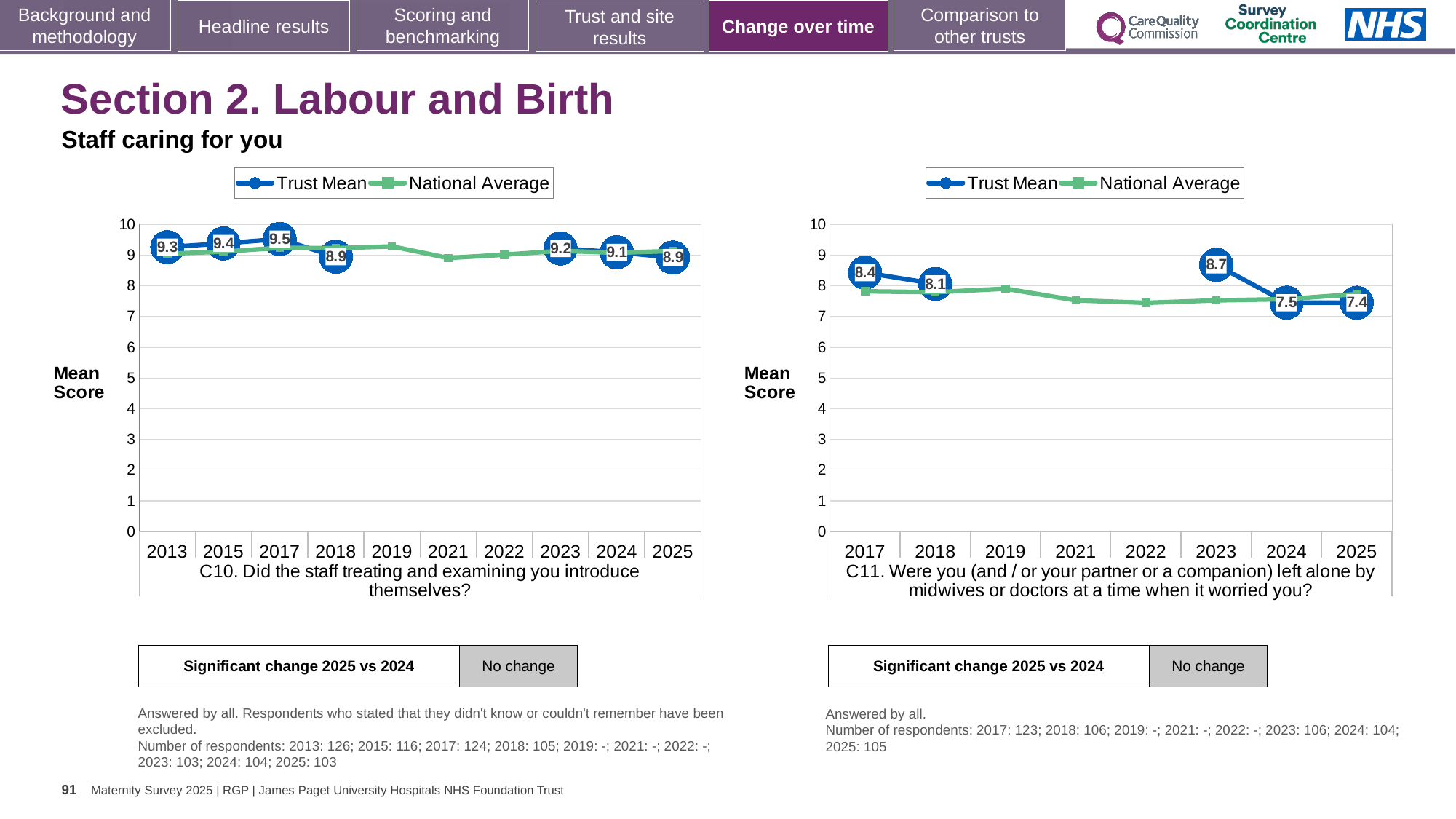
In the C11 chart on the right, is the Trust Mean for 2017 or for 2024 larger? 2017 In the C11 chart on the right, what is the Trust Mean for 2023? 8.7 In the C10 chart on the left, which year has the highest labelled Trust Mean? 2017 In the C10 chart on the left, what is the Trust Mean for 2017? 9.5 In the C11 chart on the right, what is the Trust Mean for 2025? 7.4 In the C11 chart on the right, which year has the lowest labelled Trust Mean? 2025 In the C10 chart on the left, how many years are shown on the x axis? 10 In the C11 chart on the right, is the National Average for 2022 greater or less than 8? less What type of chart is the C10 chart on the left? Line chart In the C10 chart on the left, what is the Trust Mean for 2025? 8.9 In the C10 chart on the left, what is the difference between the Trust Mean for 2017 and the Trust Mean for 2018? 0.6 In the C11 chart on the right, how many series does the legend list? 2